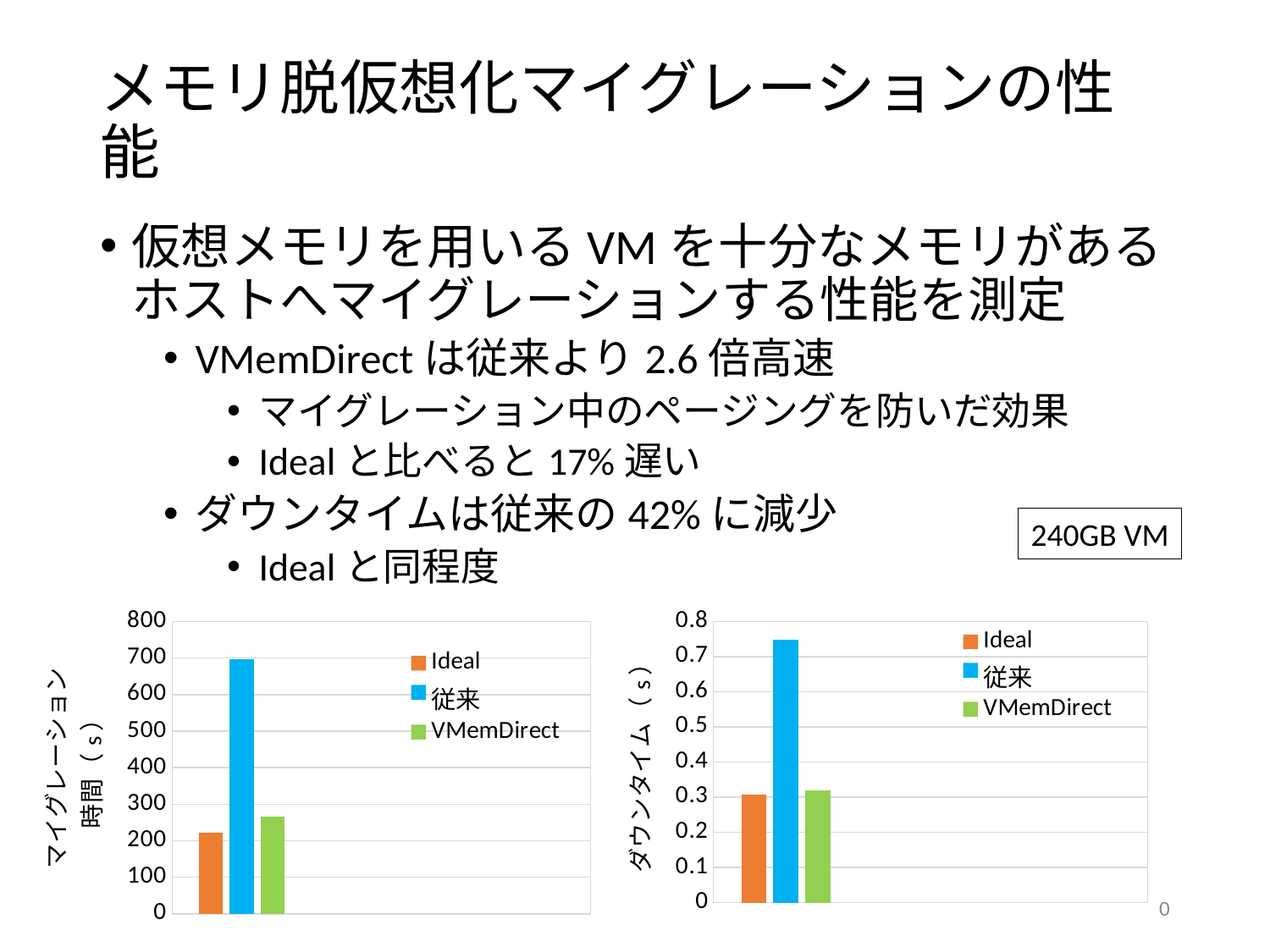
In the left chart (マイグレーション時間), is the value for Ideal greater or less than 200? greater In the left chart (マイグレーション時間), which series has the highest bar? 従来 What is the y-axis label of the right chart? ダウンタイム (s) What kind of chart is the left chart (マイグレーション時間)? bar chart In the left chart (マイグレーション時間), which is larger, the value for 従来 or the value for VMemDirect? 従来 In the right chart (ダウンタイム), is the value for 従来 greater or less than 0.7? greater In the left chart (マイグレーション時間), is the value for VMemDirect greater or less than 300? less In the left chart (マイグレーション時間), which series has the lowest bar? Ideal How many series does the legend of the right chart (ダウンタイム) list? 3 In the right chart (ダウンタイム), which series has the highest bar? 従来